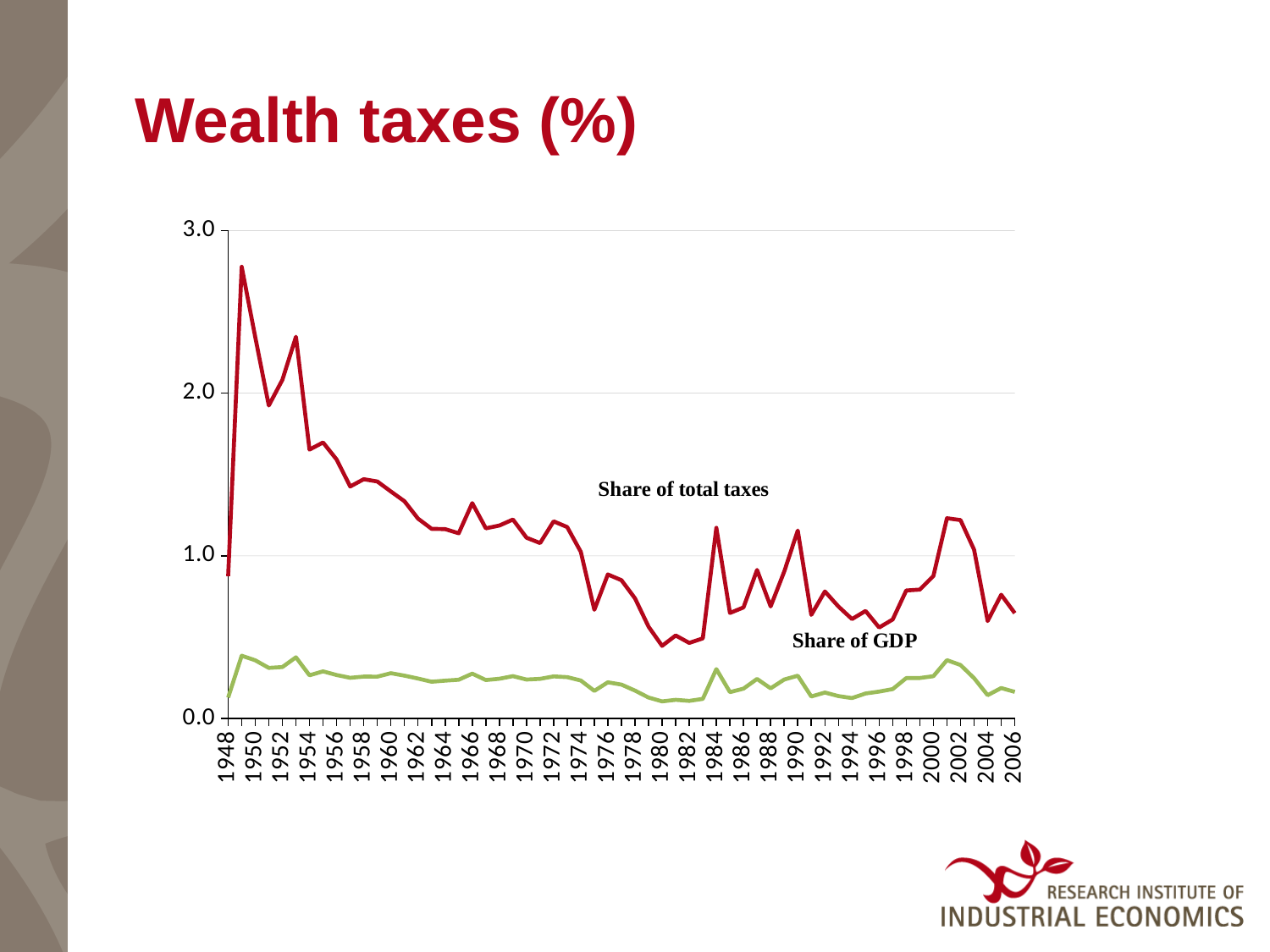
In 1970, which series has the larger value, Share of total taxes or Share of GDP? Share of total taxes Is the value for Share of total taxes in 1958 greater or less than 1.0? greater In which year does Share of total taxes reach its highest value? 1949 What is the title of the chart on the slide? Wealth taxes (%) What kind of chart is shown on the slide? Line chart Does Share of total taxes generally rise or fall between 1949 and 1980? Fall How many data series are plotted on the chart? 2 Which series is drawn in red? Share of total taxes Is the value for Share of GDP in 1960 greater or less than 1.0? less Is the value for Share of total taxes in 1980 greater or less than 1.0? less